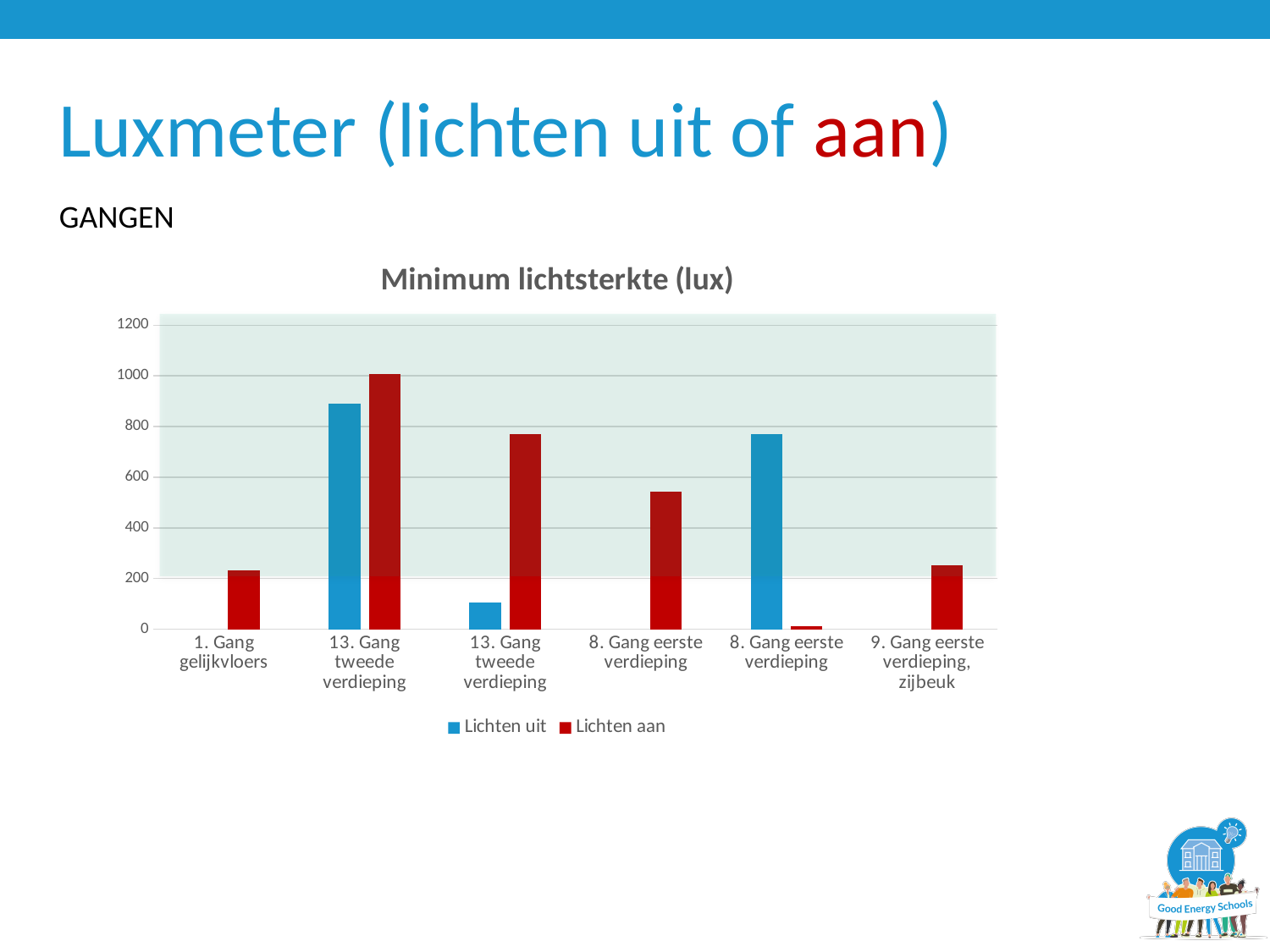
For the second category from the left (the first '13. Gang tweede verdieping'), which is larger: 'Lichten uit' or 'Lichten aan'? Lichten aan Is the 'Lichten aan' value for '9. Gang eerste verdieping, zijbeuk' greater or less than 400? less What kind of chart is shown on the slide? bar chart For the fifth category from the left (the second '8. Gang eerste verdieping'), which is larger: 'Lichten uit' or 'Lichten aan'? Lichten uit Is the 'Lichten aan' value for the second category from the left (the first '13. Gang tweede verdieping') greater or less than 800? greater What is the title of the chart? Minimum lichtsterkte (lux) How many categories are shown along the x axis of the chart? 6 Which series contains the tallest bar in the chart? Lichten aan How many series does the legend of the chart list? 2 Which colour represents the 'Lichten uit' series in the chart? blue Is the 'Lichten aan' value for '1. Gang gelijkvloers' greater or less than 400? less